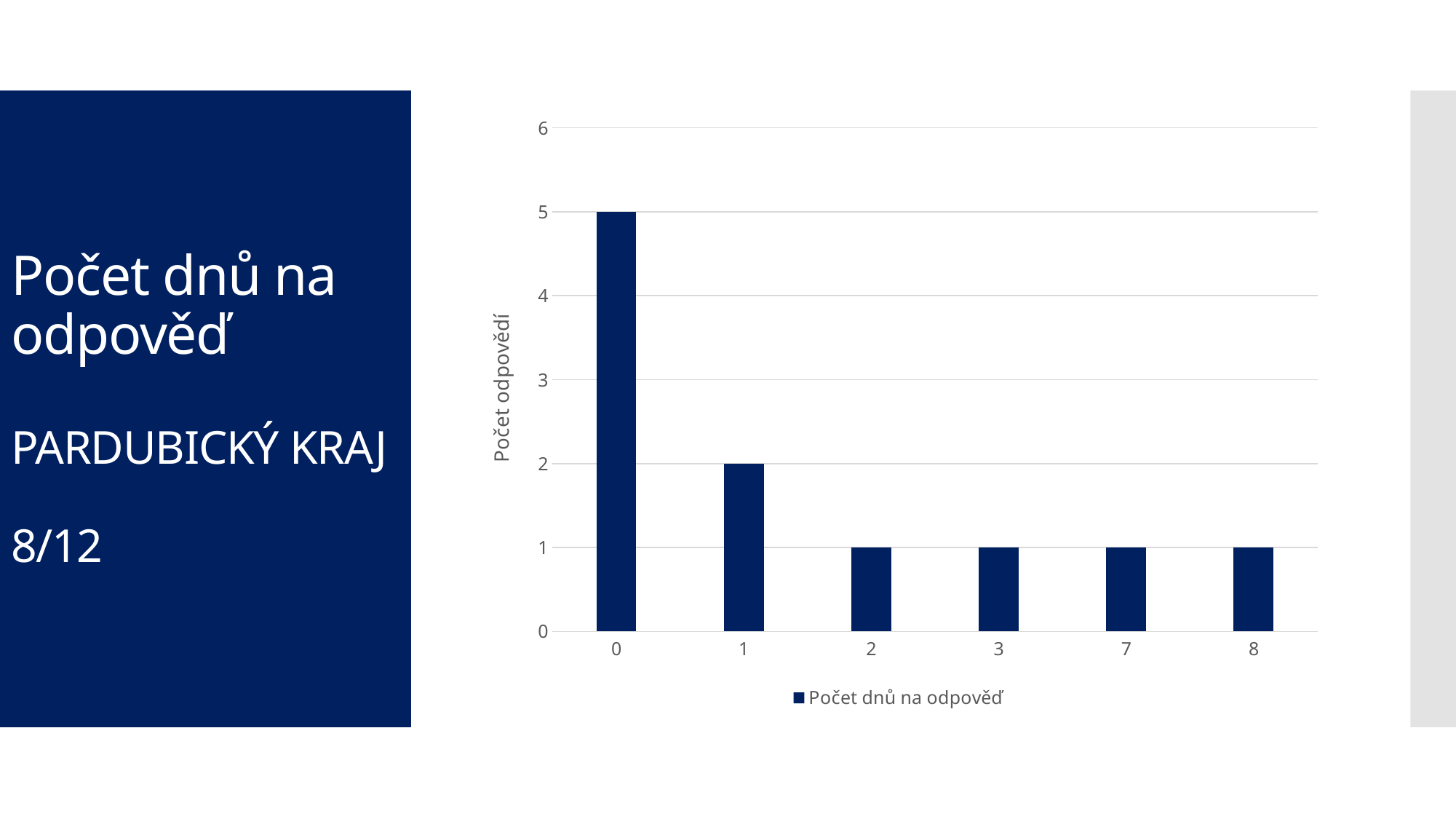
What is the label of the series in the chart legend? Počet dnů na odpověď Is the value for category 0 greater or less than 4? greater How many series does the chart legend list? 1 Which category has the highest value in the chart? 0 What is the value for category 0 in the chart? 5 How many categories are shown on the x axis of the chart? 6 Which is larger, the value for category 1 or the value for category 2? category 1 What is the label of the vertical axis of the chart? Počet odpovědí What is the difference between the values for category 0 and category 1? 3 What is the value for category 1 in the chart? 2 What kind of chart is shown on the slide? bar chart What is the value for category 7 in the chart? 1